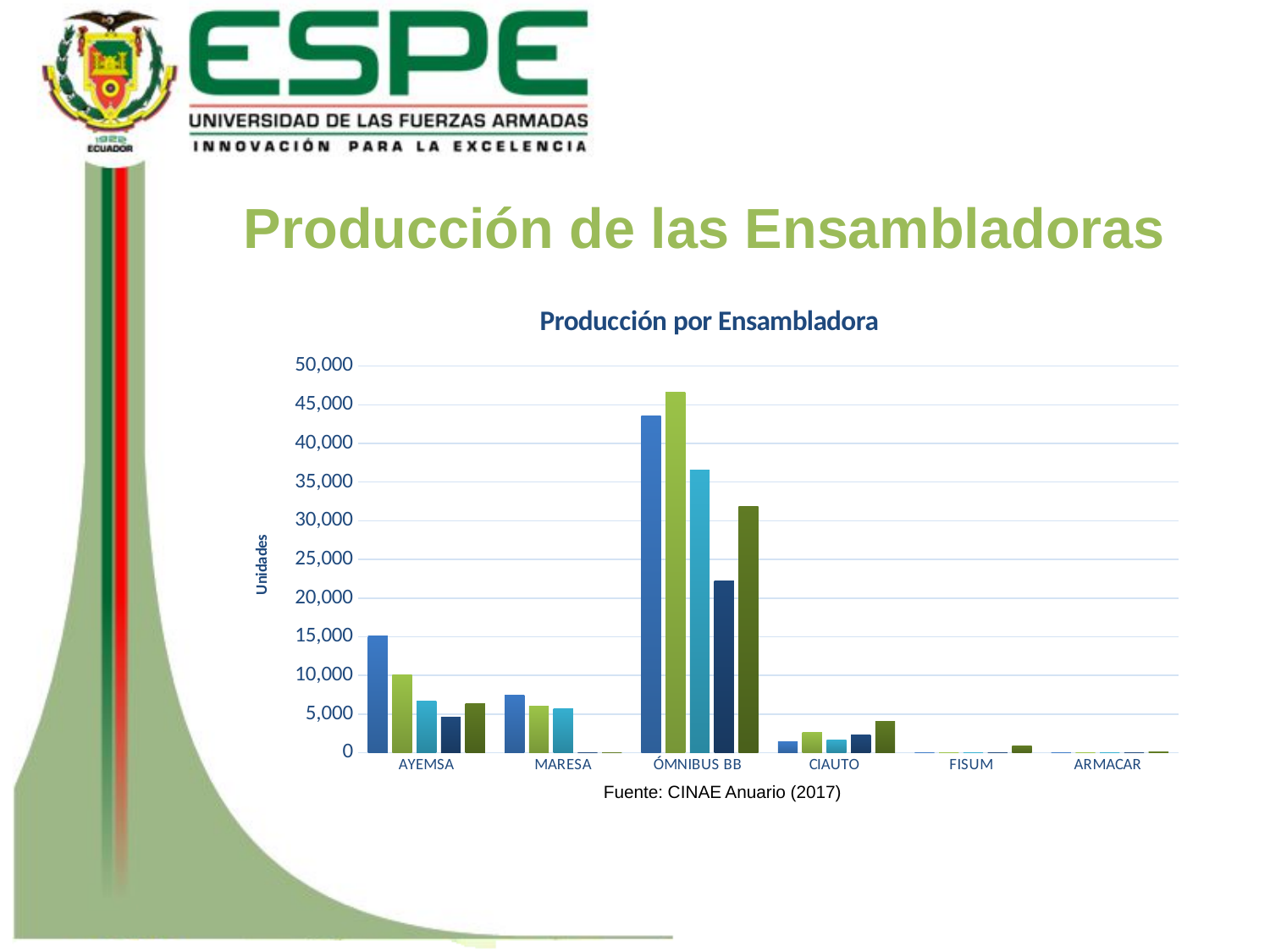
Is the tallest bar for ÓMNIBUS BB greater or less than 40,000? greater What is the highest value shown on the vertical axis of the chart? 50,000 Is the tallest bar for MARESA greater or less than 10,000? less What is the label on the vertical axis of the chart? Unidades Which assembler has the highest production bars in the chart? ÓMNIBUS BB Is the tallest bar for AYEMSA greater or less than 20,000? less Which has the taller bars overall, AYEMSA or MARESA? AYEMSA Which has the taller bars overall, CIAUTO or ÓMNIBUS BB? ÓMNIBUS BB How many assembler categories are shown on the x axis of the chart? 6 What is the title of the chart? Producción por Ensambladora What kind of chart is shown on the slide? bar chart